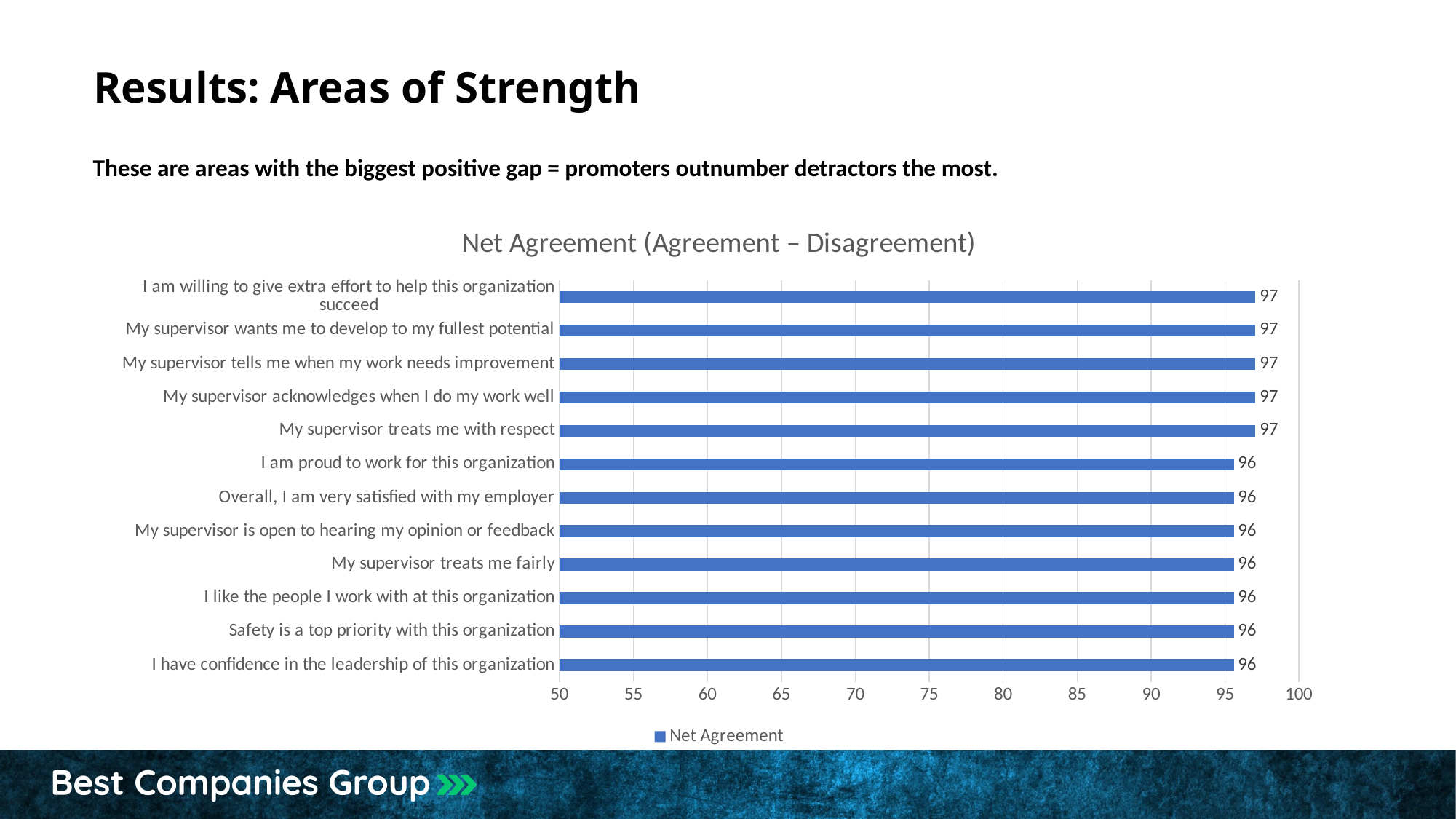
What is the difference between the net agreement for "My supervisor acknowledges when I do my work well" and "My supervisor treats me fairly"? 1 What type of chart is shown on the slide? Bar chart What is the net agreement value for "I am willing to give extra effort to help this organization succeed"? 97 What is the net agreement value for "Safety is a top priority with this organization"? 96 How many series does the chart legend list? 1 How many statements (categories) are shown in the chart? 12 What is the net agreement value for "I have confidence in the leadership of this organization"? 96 What is the name of the series shown in the chart legend? Net Agreement Is the net agreement value for "Overall, I am very satisfied with my employer" greater or less than 90? greater What is the title of the chart? Net Agreement (Agreement – Disagreement) Which has a higher net agreement value: "My supervisor tells me when my work needs improvement" or "I am proud to work for this organization"? My supervisor tells me when my work needs improvement What is the net agreement value for "My supervisor treats me with respect"? 97